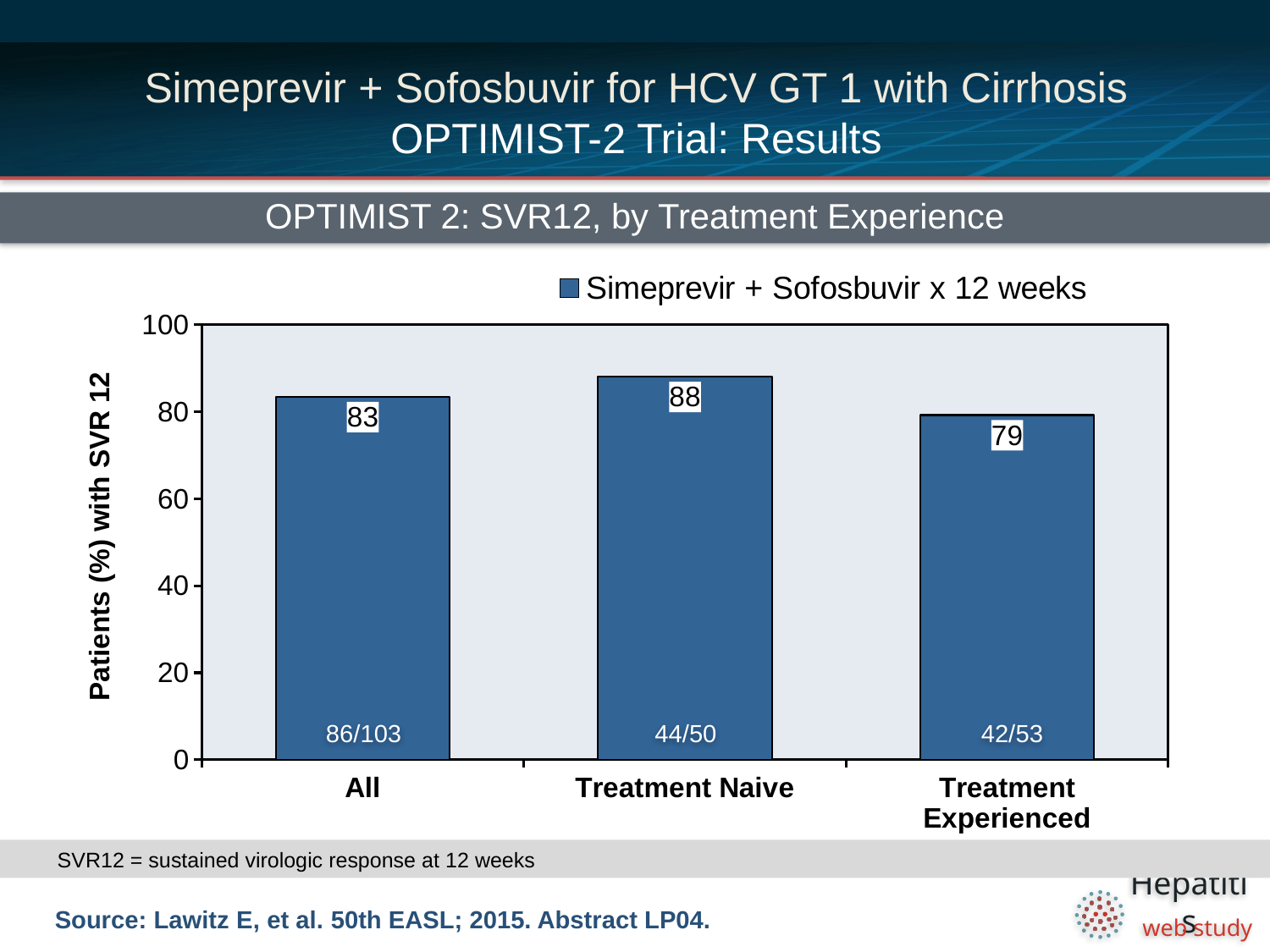
Which group has the lowest SVR12 rate? Treatment Experienced What is the label of the y axis? Patients (%) with SVR 12 Which group has a higher SVR12 rate, All or Treatment Experienced? All What fraction of patients is shown inside the Treatment Naive bar? 44/50 How many series does the legend list? 1 What is the SVR12 value for the Treatment Experienced group? 79 Which group has the highest SVR12 rate? Treatment Naive How many groups are shown on the x axis? 3 What is the SVR12 value for the All group? 83 What is the SVR12 value for the Treatment Naive group? 88 What kind of chart is shown? Bar chart What is the difference in SVR12 between the Treatment Naive and Treatment Experienced groups? 9